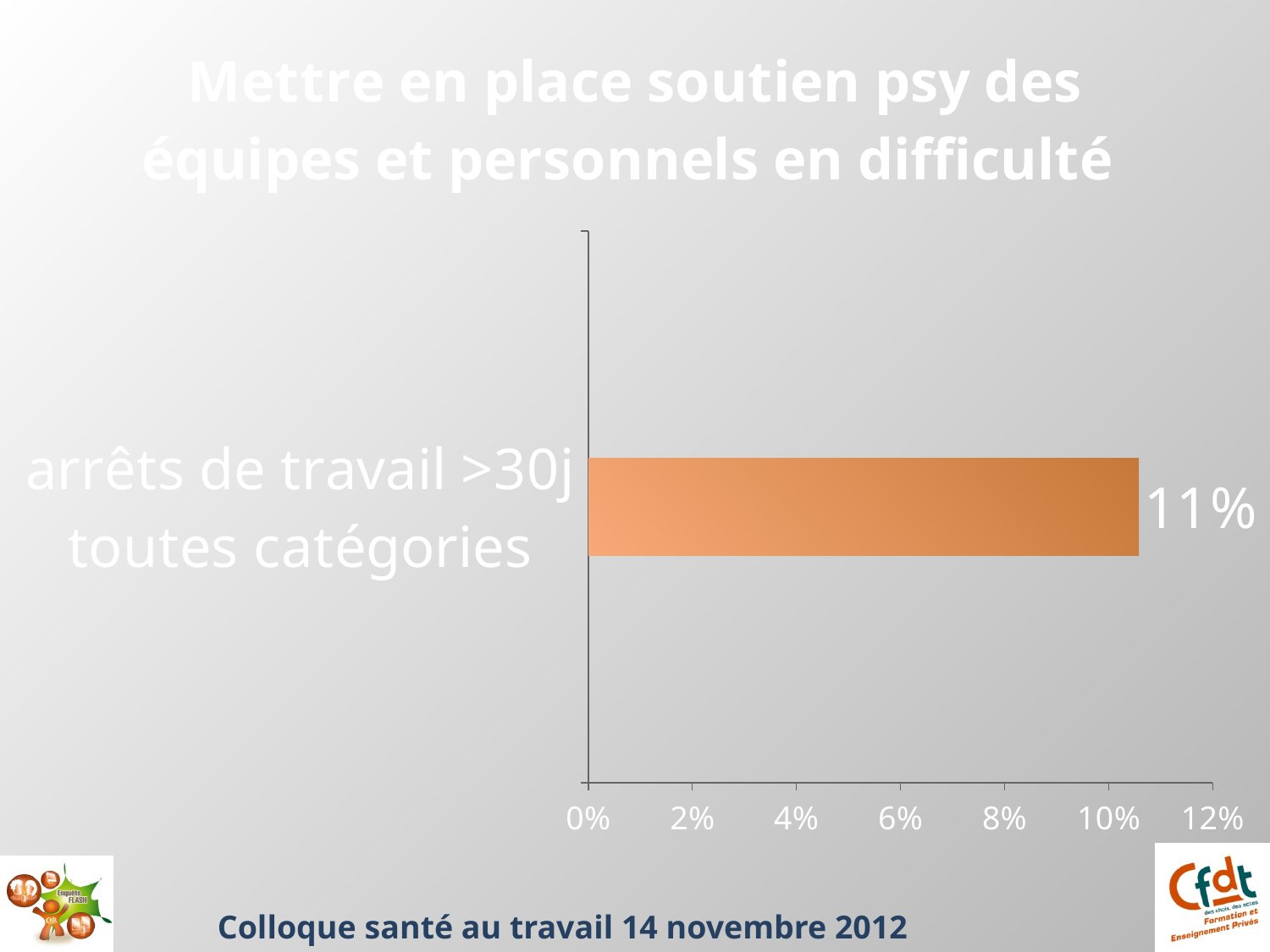
Is the value for "arrêts de travail >30j toutes catégories" greater or less than 12%? less How many bars does the chart contain? 1 What is the maximum value shown on the horizontal axis? 12% What kind of chart is shown on the slide? bar chart Is the value for "arrêts de travail >30j toutes catégories" greater or less than 10%? greater What is the label of the category plotted in the chart? arrêts de travail >30j toutes catégories What is the value shown for "arrêts de travail >30j toutes catégories"? 11% What is the title of the chart? Mettre en place soutien psy des équipes et personnels en difficulté